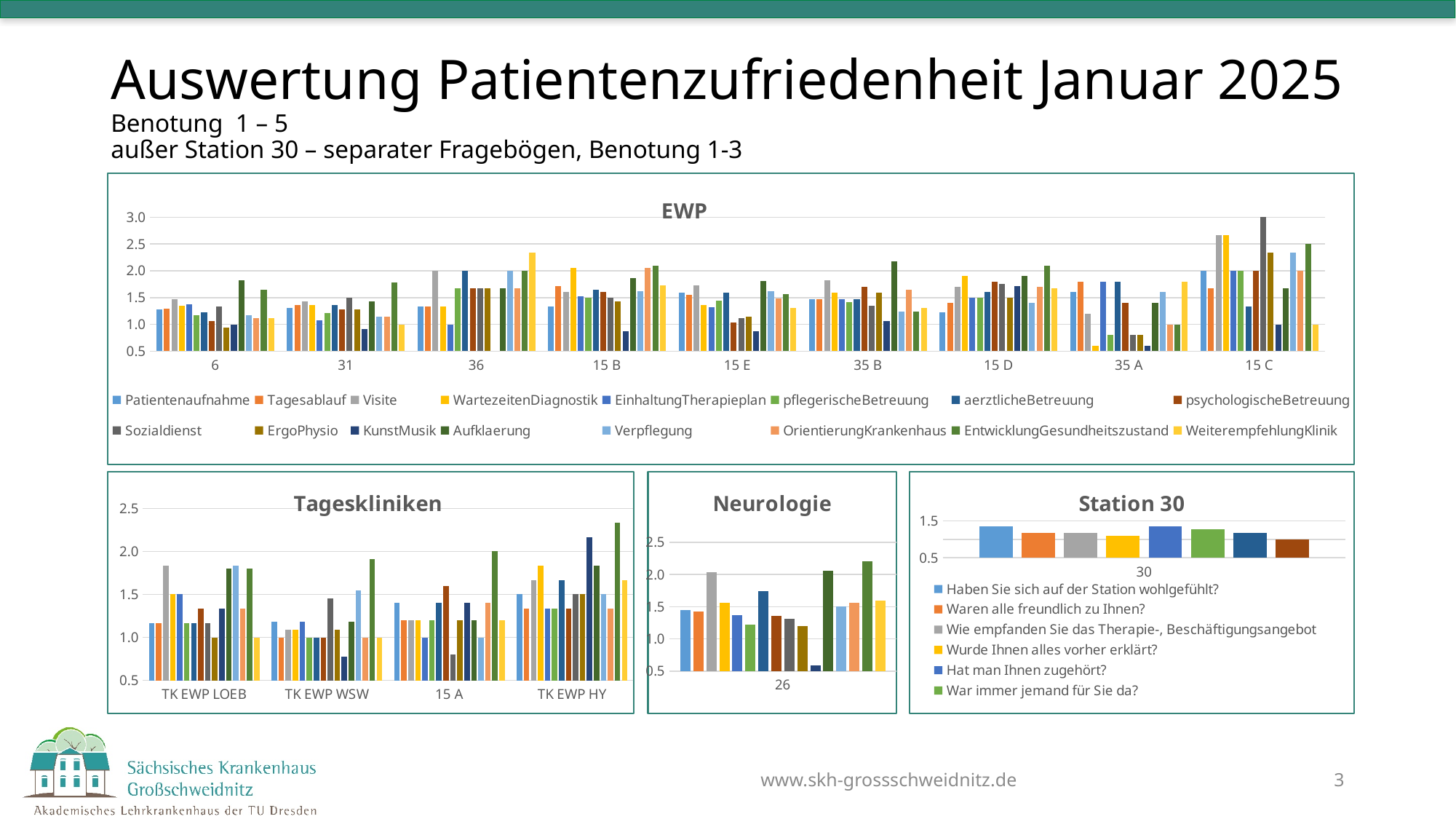
In the Neurologie chart, is the KunstMusik value greater or less than 1.0? less In the Tageskliniken chart, which category contains the tallest bar? TK EWP HY In the EWP chart, is the Sozialdienst value for station 15 C greater or less than 2.5? greater What is the only category label on the x axis of the Neurologie chart? 26 How many categories are shown on the x axis of the Tageskliniken chart? 4 How many series does the legend of the EWP chart list? 16 In the EWP chart, which station category contains the tallest bar? 15 C What is the highest value shown on the y axis of the Station 30 chart? 1.5 What type of chart is the EWP chart? bar chart How many station categories are shown on the x axis of the EWP chart? 9 How many series does the legend of the Station 30 chart list? 6